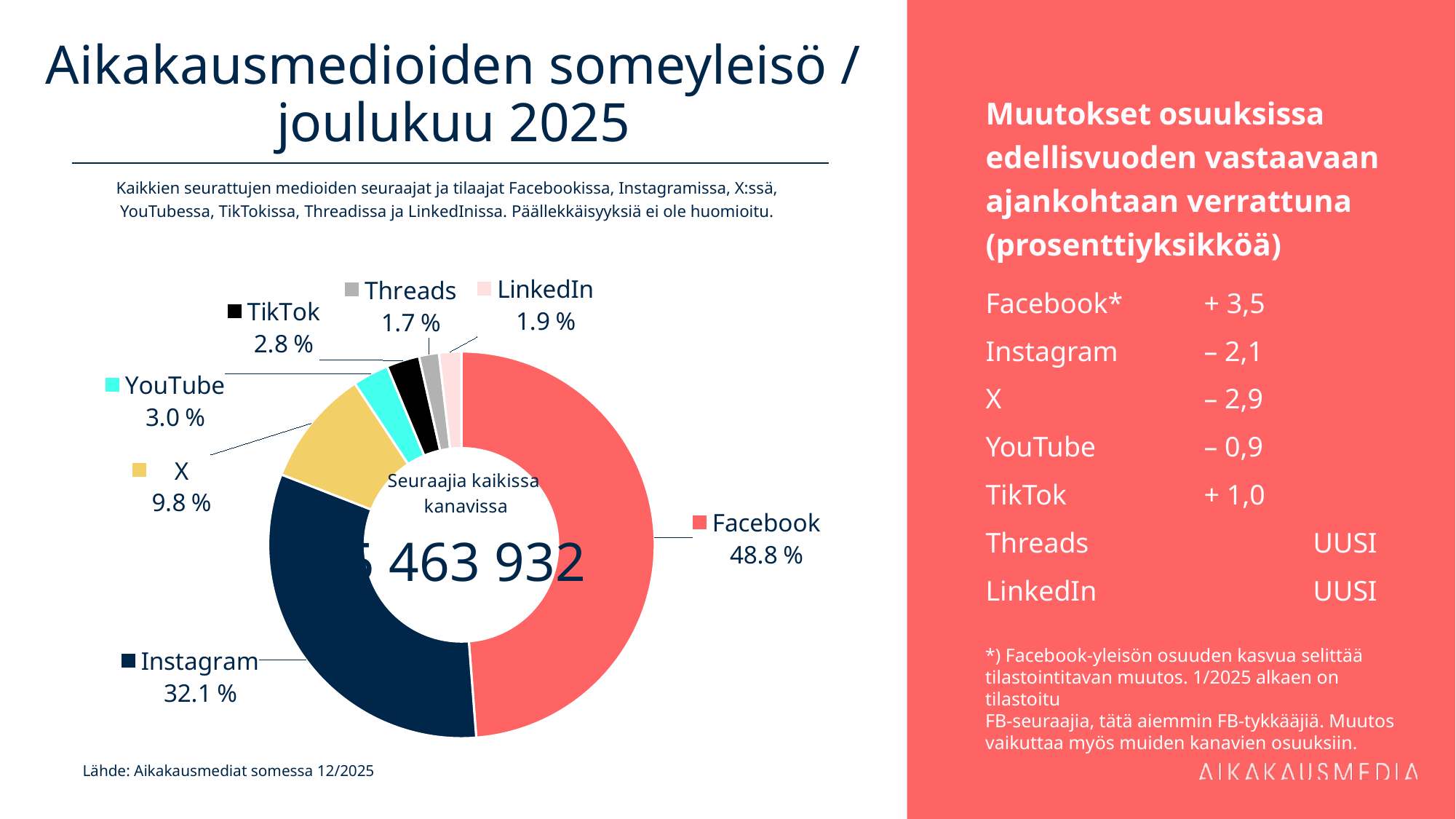
What share does LinkedIn have in the chart? 1.9 % What share does X have in the chart? 9.8 % What share of the social media audience does Instagram have? 32.1 % Which channel has the largest share in the chart? Facebook Which has a larger share, YouTube or TikTok? YouTube How many channels (slices) are shown in the chart? 7 What kind of chart is shown on the slide? Doughnut (pie) chart Which channel has the smallest share in the chart? Threads What share of the social media audience does Facebook have? 48.8 % What is the difference in percentage points between Facebook's and Instagram's shares? 16.7 percentage points What share does YouTube have in the chart? 3.0 % What share does TikTok have in the chart? 2.8 %